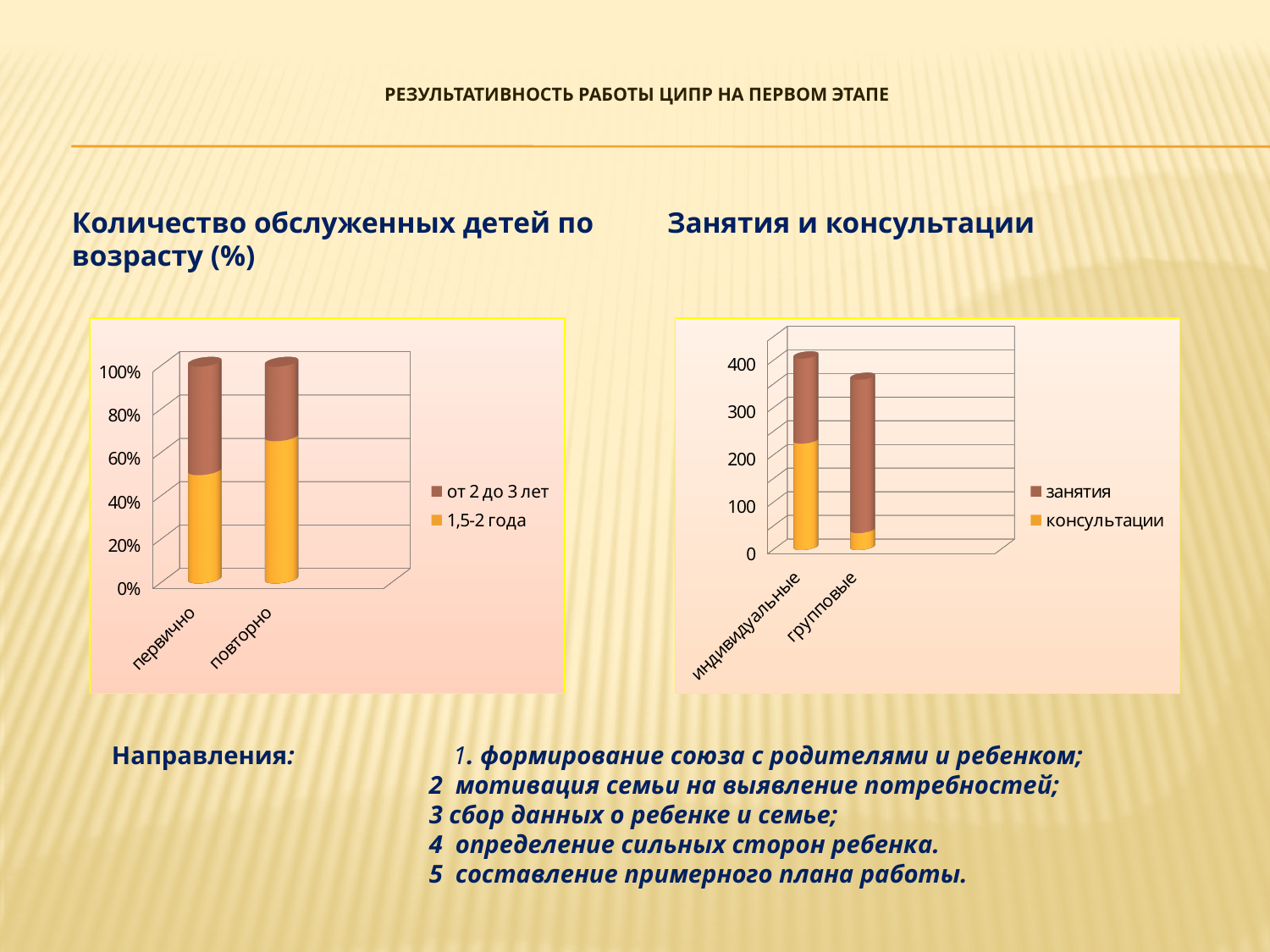
In the chart "Занятия и консультации", is the value of "консультации" for "индивидуальные" greater or less than 100? greater How many series does the legend of the chart "Количество обслуженных детей по возрасту (%)" list? 2 In the chart "Количество обслуженных детей по возрасту (%)", how many categories are shown on the x axis? 2 What kind of chart is the chart titled "Количество обслуженных детей по возрасту (%)"? bar chart In the chart "Занятия и консультации", which category has the taller total bar, "индивидуальные" or "групповые"? индивидуальные How many series does the legend of the chart "Занятия и консультации" list? 2 In the chart "Количество обслуженных детей по возрасту (%)", is the value of "1,5-2 года" for "повторно" greater or less than 60%? greater What are the two legend entries of the chart "Занятия и консультации"? занятия, консультации What kind of chart is the chart titled "Занятия и консультации"? bar chart In the chart "Занятия и консультации", is the value of "консультации" for "групповые" greater or less than 100? less In the chart "Количество обслуженных детей по возрасту (%)", is the share of "1,5-2 года" larger for "первично" or for "повторно"? повторно In the chart "Занятия и консультации", how many categories are shown on the x axis? 2